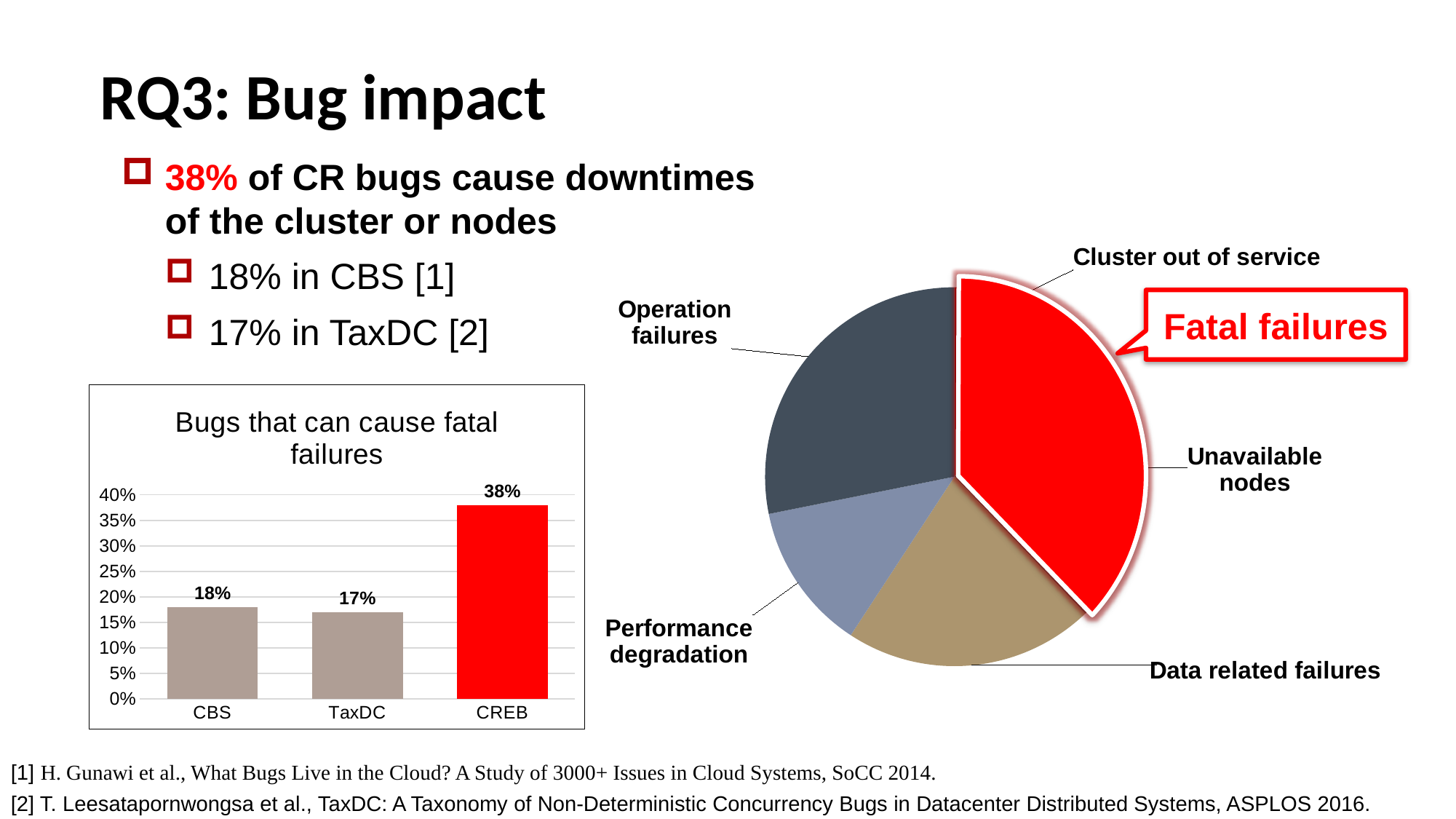
In the pie chart on the right side of the slide, which slice is larger, Data related failures or Performance degradation? Data related failures In the bar chart titled "Bugs that can cause fatal failures", which category has the lowest value? TaxDC In the bar chart titled "Bugs that can cause fatal failures", which is larger, the value for CBS or the value for TaxDC? CBS In the bar chart titled "Bugs that can cause fatal failures", how many categories are shown on the x axis? 3 In the bar chart titled "Bugs that can cause fatal failures", what is the value for CREB? 38% In the bar chart titled "Bugs that can cause fatal failures", which category has the highest value? CREB In the bar chart titled "Bugs that can cause fatal failures", what is the value for TaxDC? 17% What kind of chart is the chart titled "Bugs that can cause fatal failures"? Bar chart In the bar chart titled "Bugs that can cause fatal failures", what is the value for CBS? 18% In the pie chart on the right side of the slide, how many slices are labelled? 5 In the bar chart titled "Bugs that can cause fatal failures", what is the difference between the values for CREB and CBS? 20% What kind of chart is the chart on the right side of the slide? Pie chart